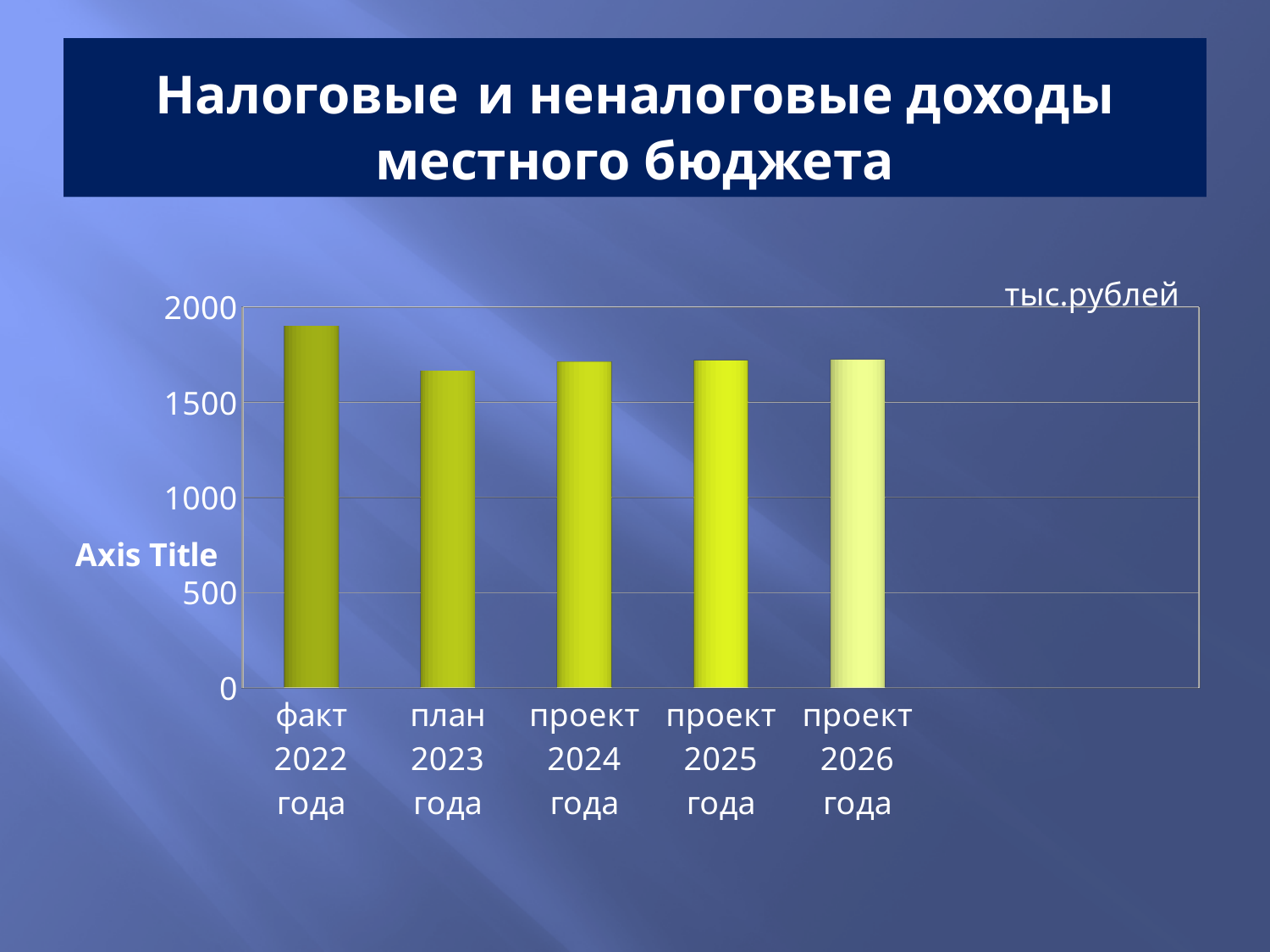
Is the value for факт 2022 года greater or less than 2000? less How many categories (bars) are shown in the chart? 5 What unit is indicated in the top right corner of the chart? тыс.рублей What kind of chart is shown on the slide? bar chart Is the value for проект 2026 года greater or less than 2000? less Which is larger: the value for факт 2022 года or the value for план 2023 года? факт 2022 года Is the value for факт 2022 года greater or less than 1500? greater Which category has the lowest value in the chart? план 2023 года What is the title of the chart on the slide? Налоговые и неналоговые доходы местного бюджета Which category has the highest value in the chart? факт 2022 года